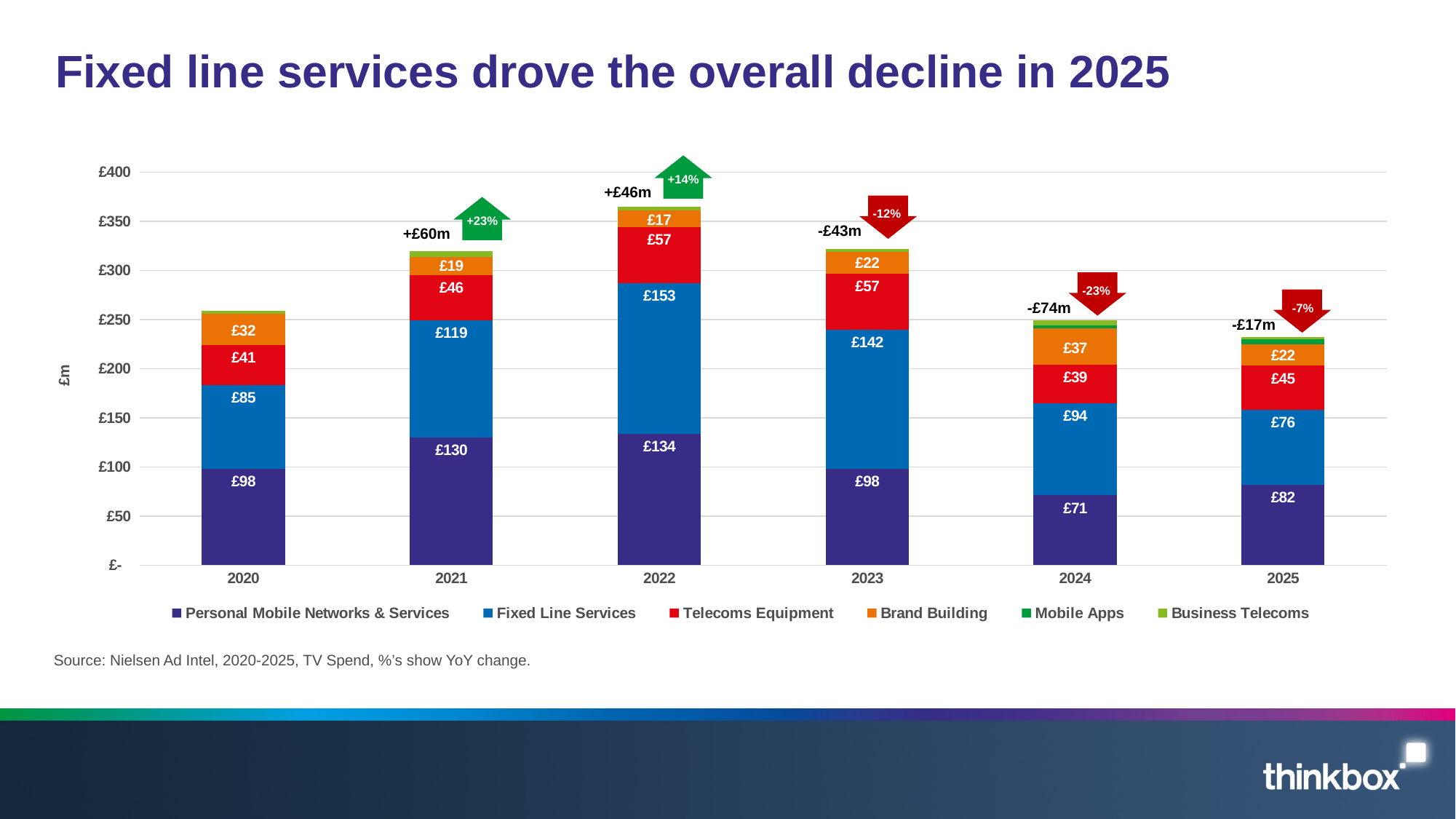
By how much did Fixed Line Services fall from 2024 to 2025? £18 How many years are shown on the x axis? 6 What kind of chart is shown on the slide? Stacked bar chart What year-on-year percentage change is shown above the 2024 bar? -23% What is the value for Personal Mobile Networks & Services in 2024? £71 In which year is the Personal Mobile Networks & Services segment lowest? 2024 What is the value for Fixed Line Services in 2022? £153 In which year is the Fixed Line Services segment highest? 2022 What is the value for Brand Building in 2020? £32 Is the total height of the 2022 bar greater or less than £350? greater Which is larger: Telecoms Equipment in 2020 or in 2025? 2025 How many series does the legend list? 6